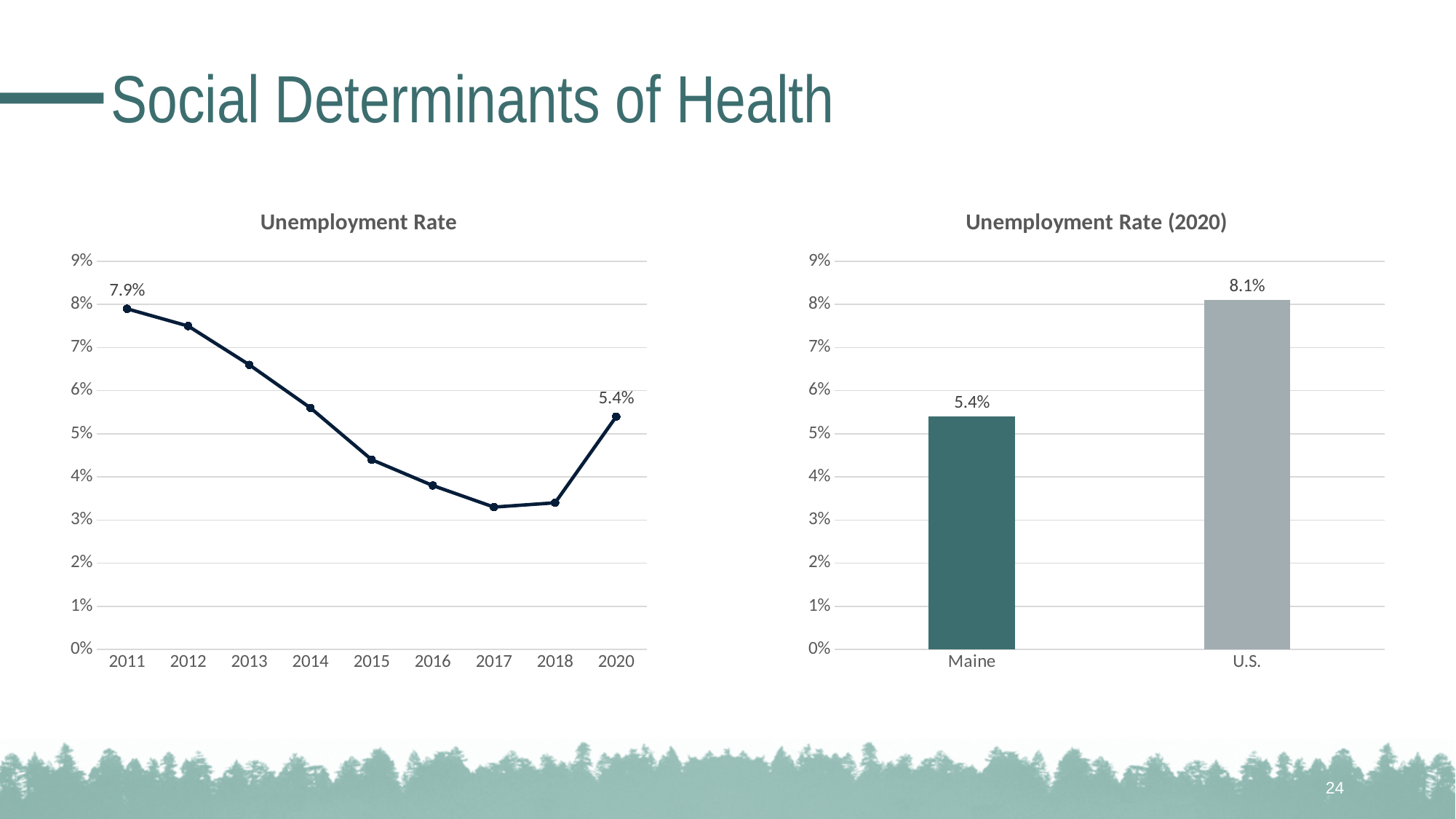
In the 'Unemployment Rate' line chart, is the value for 2017 greater or less than 4%? less In the 'Unemployment Rate' line chart, how many years are plotted on the x axis? 9 In the 'Unemployment Rate (2020)' chart, what is the value for U.S.? 8.1% In the 'Unemployment Rate' line chart, which year has the lowest unemployment rate? 2017 In the 'Unemployment Rate' line chart, is the value for 2014 greater or less than 5%? greater In the 'Unemployment Rate (2020)' chart, what is the value for Maine? 5.4% What kind of chart is the 'Unemployment Rate (2020)' chart on the right? bar chart In the 'Unemployment Rate' line chart, what is the value for 2011? 7.9% In the 'Unemployment Rate (2020)' chart, what is the difference between the U.S. and Maine values? 2.7% In the 'Unemployment Rate' line chart, does the unemployment rate rise or fall from 2011 to 2017? fall In the 'Unemployment Rate' line chart, which year has the highest unemployment rate? 2011 In the 'Unemployment Rate' line chart, what is the value for 2020? 5.4%